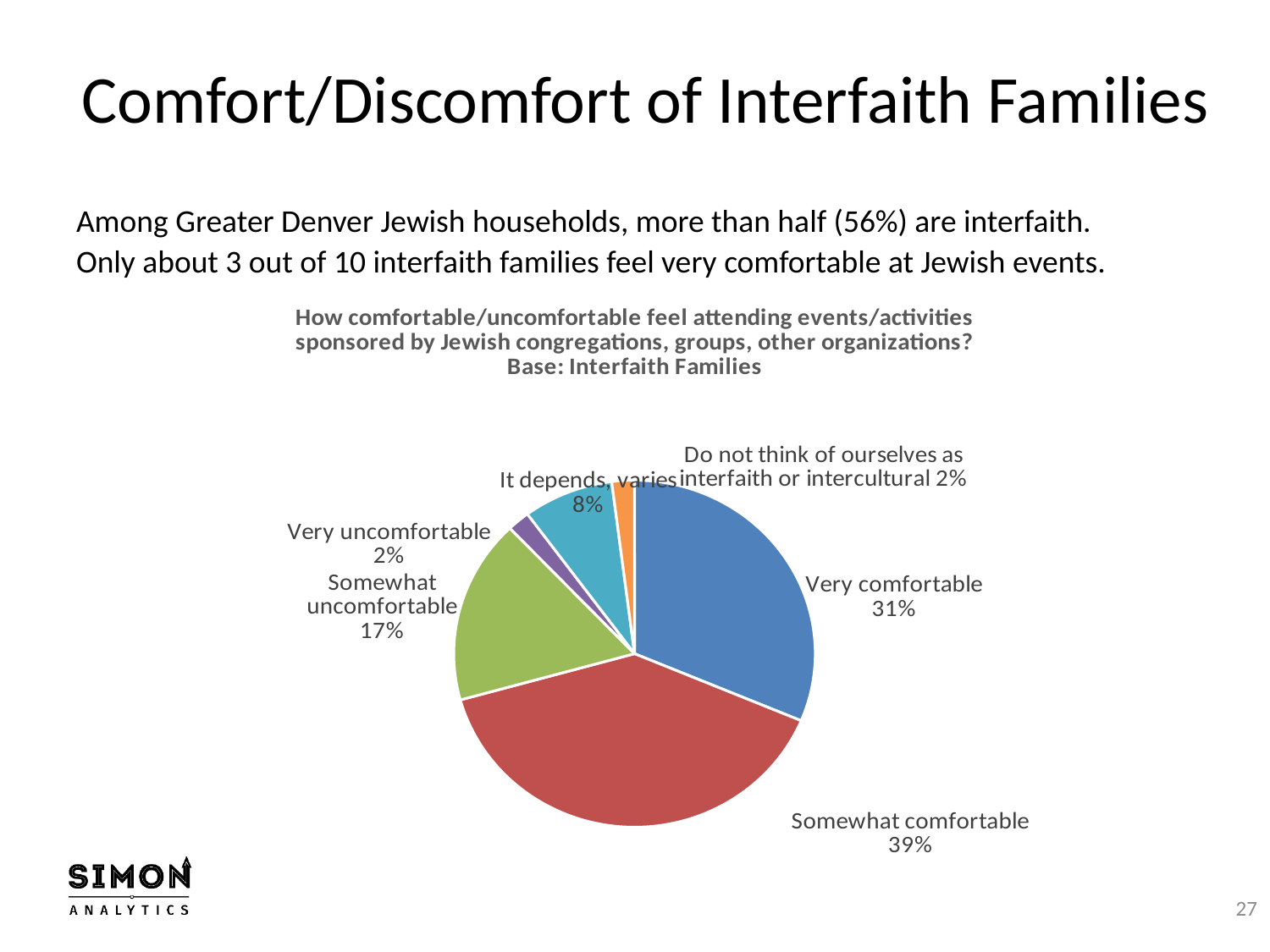
What percentage of interfaith families feel somewhat comfortable? 39% What percentage of respondents do not think of themselves as interfaith or intercultural? 2% How many slices does the pie chart have? 6 What is the base population stated in the chart title? Interfaith Families Which is larger: the share for 'Very comfortable' or the share for 'Somewhat uncomfortable'? Very comfortable What share of interfaith families feel very comfortable attending Jewish-sponsored events? 31% What percentage of interfaith families feel somewhat uncomfortable? 17% What share of respondents answered 'It depends, varies'? 8% What is the combined share of 'Very comfortable' and 'Somewhat comfortable'? 70% Which response category has the largest slice of the pie? Somewhat comfortable What is the difference in percentage points between 'Somewhat comfortable' and 'Very comfortable'? 8 What kind of chart is shown on the slide? Pie chart